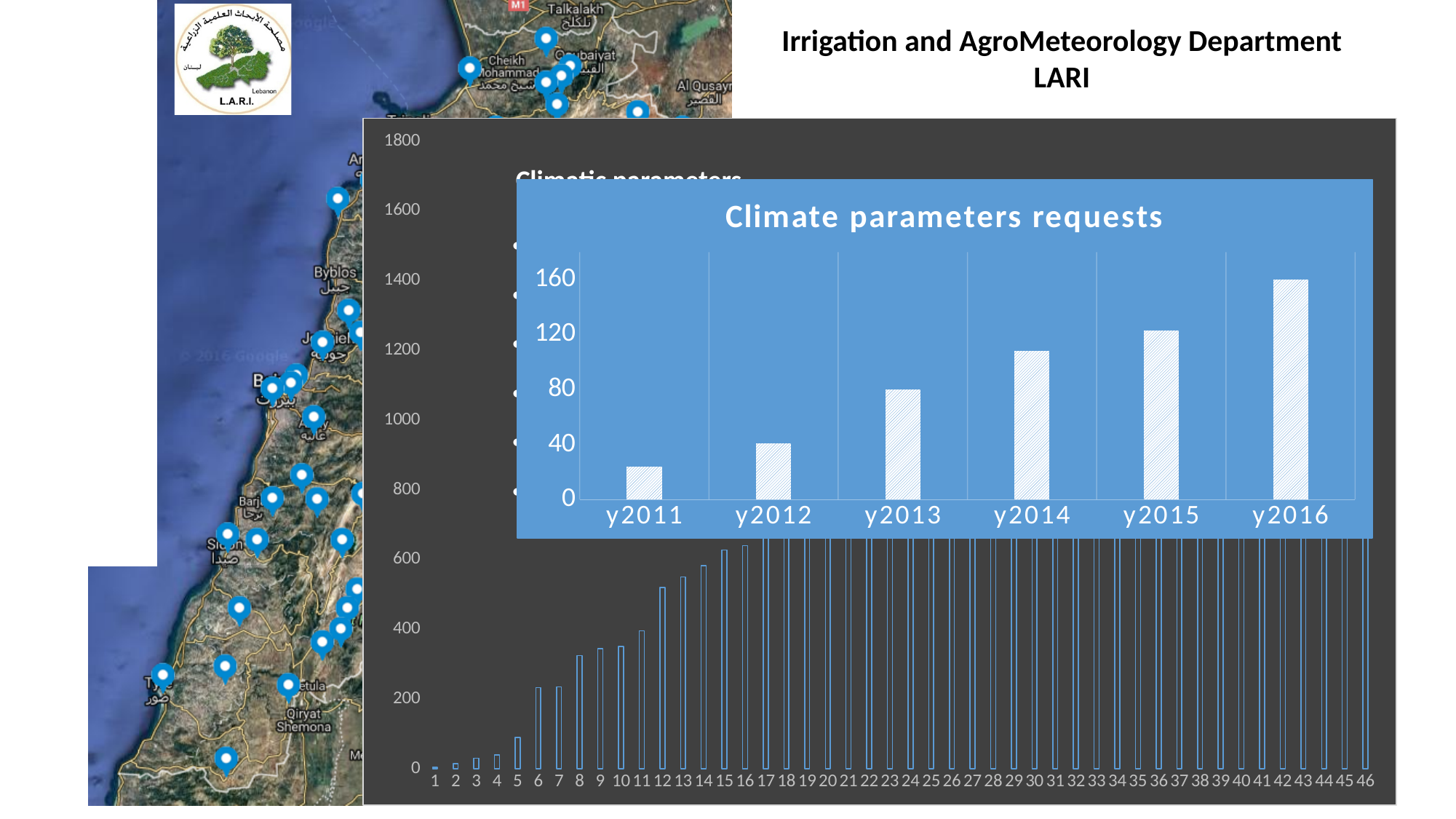
In the 'Climate parameters requests' chart, is the value for y2014 greater or less than 80? greater In the 'Climate parameters requests' chart, is the value for y2011 greater or less than 40? less In the 'Climate parameters requests' chart, which year has the lowest value? y2011 How many years are shown on the x axis of the 'Climate parameters requests' chart? 6 In the 'Climate parameters requests' chart, do the values rise or fall from y2011 to y2016? rise How many categories are shown on the x axis of the large dark-background chart behind the 'Climate parameters requests' chart? 46 In the 'Climate parameters requests' chart, is the value for y2016 greater or less than 120? greater In the 'Climate parameters requests' chart, which year has the highest value? y2016 In the 'Climate parameters requests' chart, which is larger, the value for y2015 or the value for y2013? y2015 What kind of chart is the 'Climate parameters requests' chart? bar chart